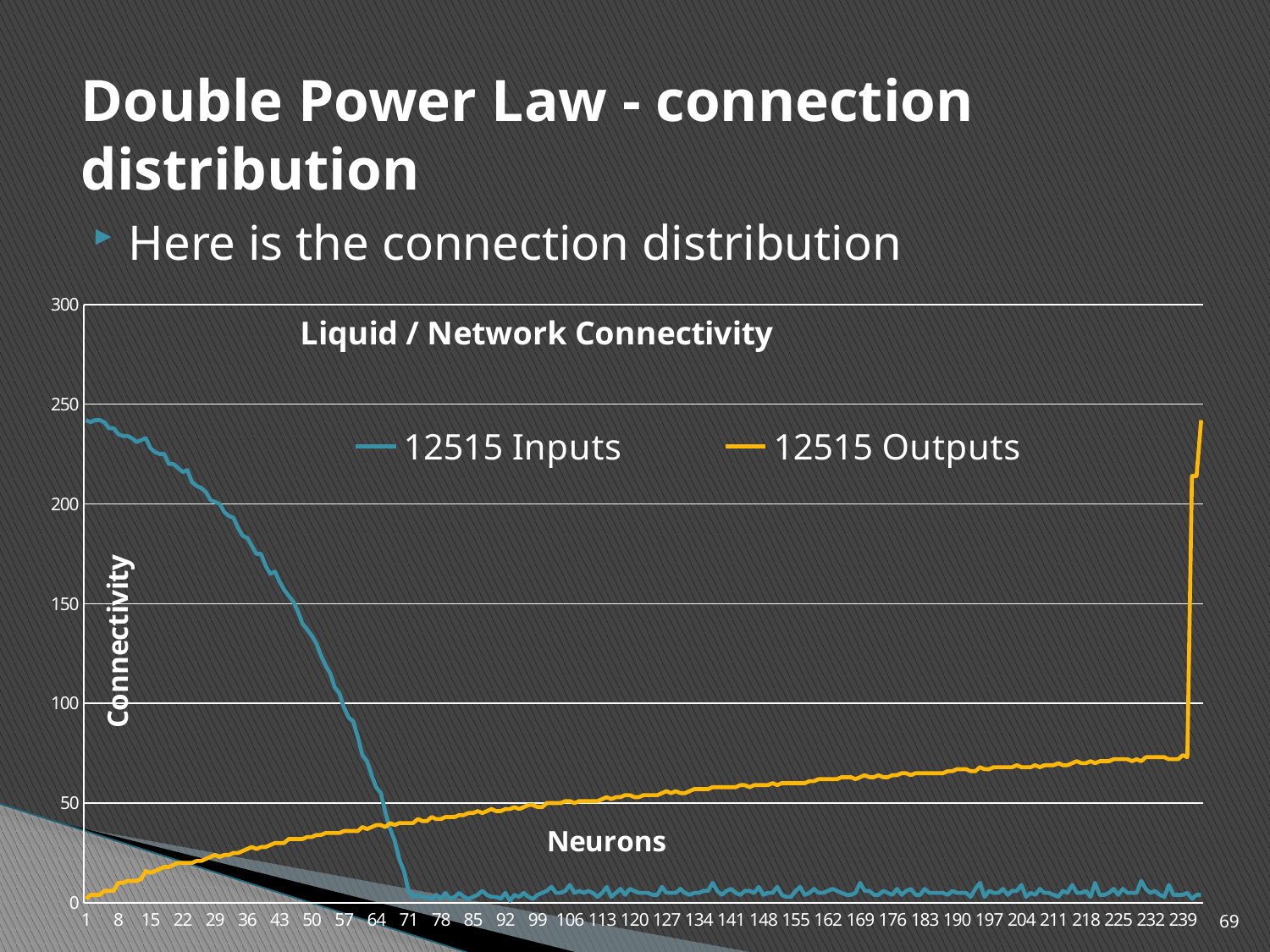
What kind of chart is shown on the slide? line chart Do the values of the 12515 Outputs series rise or fall as the neuron number increases along the x axis? rise At neuron 239, which series has the larger value, 12515 Inputs or 12515 Outputs? 12515 Outputs What is the label of the vertical axis of the chart? Connectivity What is the title of the chart? Liquid / Network Connectivity Is the value of 12515 Inputs at neuron 1 greater or less than 200? greater Is the value of 12515 Outputs at neuron 1 greater or less than 50? less Is the value of 12515 Inputs at neuron 99 greater or less than 50? less At neuron 1, which series has the larger value, 12515 Inputs or 12515 Outputs? 12515 Inputs How many series does the chart legend list? 2 Do the values of the 12515 Inputs series rise or fall as the neuron number increases along the x axis? fall